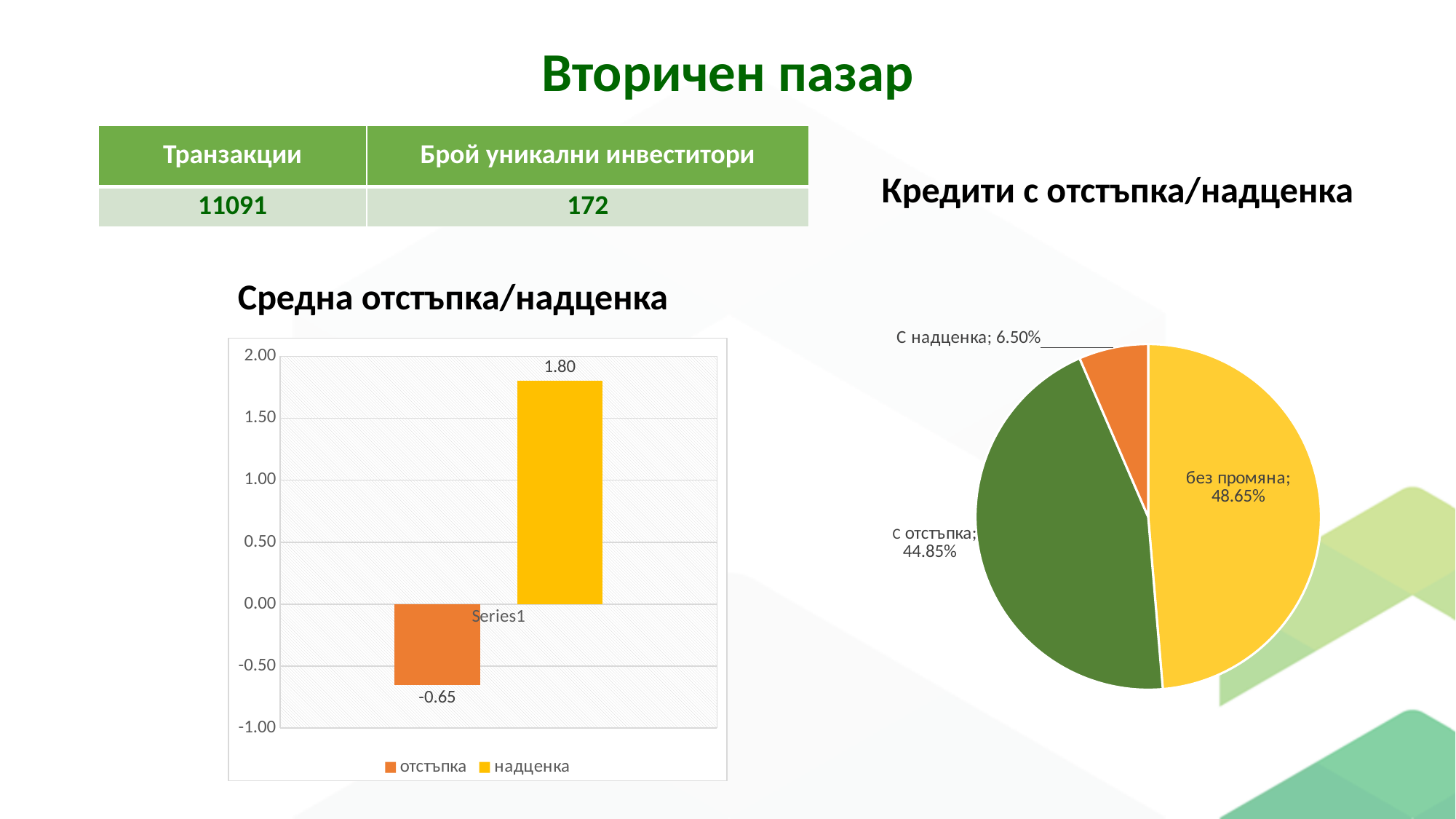
In the bar chart 'Средна отстъпка/надценка', how many series does the legend list? 2 In the pie chart 'Кредити с отстъпка/надценка', which slice is the smallest? С надценка In the bar chart 'Средна отстъпка/надценка', what is the value for надценка? 1.80 In the bar chart 'Средна отстъпка/надценка', which series has the higher value, отстъпка or надценка? надценка In the pie chart 'Кредити с отстъпка/надценка', what share does 'без промяна' have? 48.65% In the bar chart 'Средна отстъпка/надценка', what is the value for отстъпка? -0.65 In the pie chart 'Кредити с отстъпка/надценка', what share does 'с отстъпка' have? 44.85% What kind of chart is 'Средна отстъпка/надценка'? bar chart In the bar chart 'Средна отстъпка/надценка', what colour is the надценка bar? yellow In the pie chart 'Кредити с отстъпка/надценка', what share does 'С надценка' have? 6.50% How many slices does the pie chart 'Кредити с отстъпка/надценка' have? 3 In the bar chart 'Средна отстъпка/надценка', what is the difference between the надценка value and the отстъпка value? 2.45